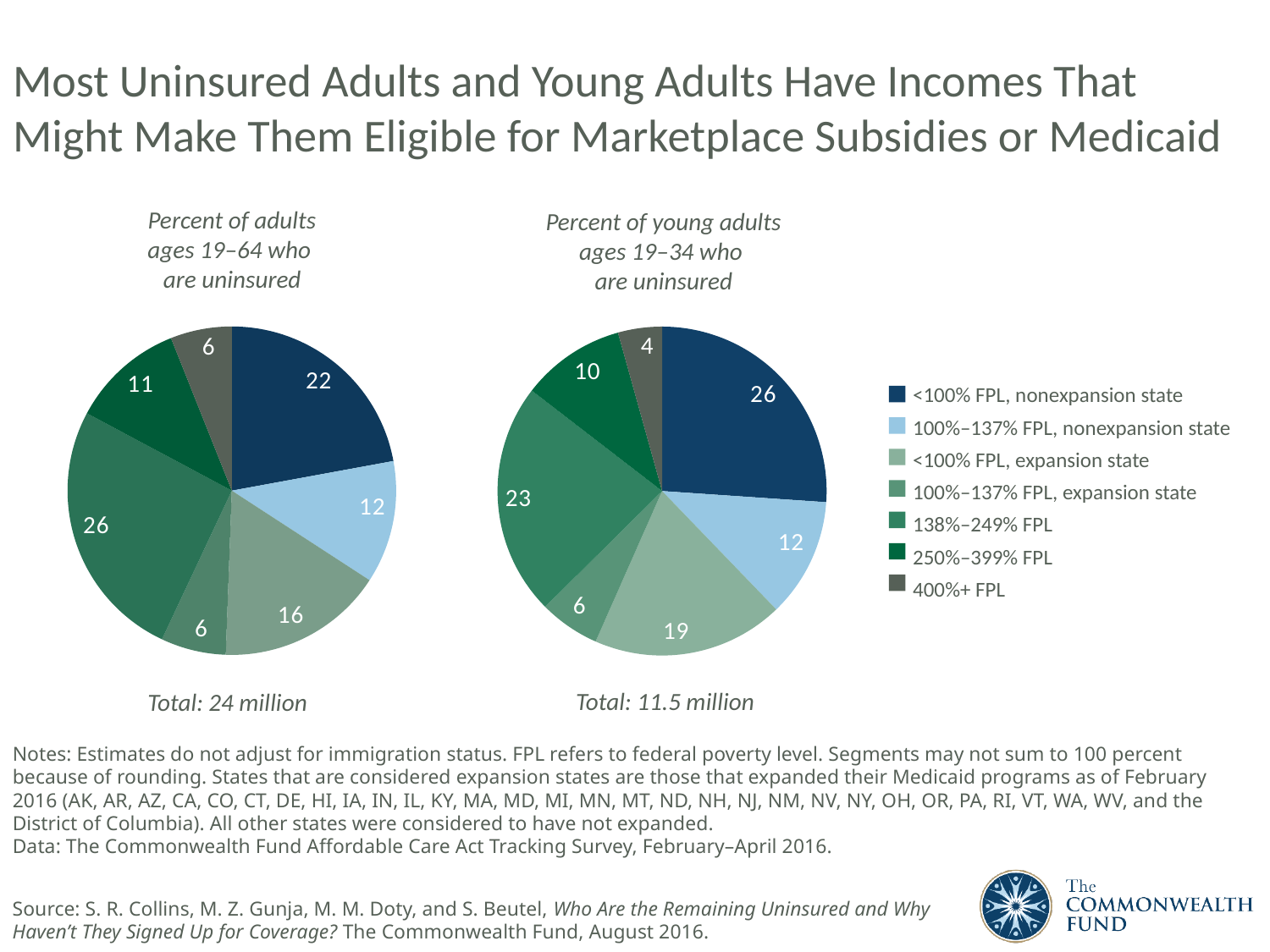
How many slices does the pie chart for young adults ages 19–34 who are uninsured have? 7 What is the difference between the <100% FPL, nonexpansion state share for young adults ages 19–34 and the same share for adults ages 19–64? 4 In the pie chart for young adults ages 19–34 who are uninsured, what percent are in the <100% FPL, expansion state group? 19 What type of chart is used to show the percent of adults ages 19–64 who are uninsured? Pie chart In the pie chart for young adults ages 19–34 who are uninsured, which income group has the largest share? <100% FPL, nonexpansion state In the pie chart for adults ages 19–64 who are uninsured, what percent are in the 400%+ FPL group? 6 In the pie chart for young adults ages 19–34 who are uninsured, which income group has the smallest share? 400%+ FPL In the pie chart for adults ages 19–64 who are uninsured, which income group has the largest share? 138%–249% FPL What total is shown beneath the pie chart for young adults ages 19–34 who are uninsured? Total: 11.5 million In the pie chart for adults ages 19–64 who are uninsured, which is larger: the <100% FPL, expansion state share or the 250%–399% FPL share? <100% FPL, expansion state In the pie chart for adults ages 19–64 who are uninsured, what percent are in the 138%–249% FPL group? 26 How many entries does the legend list? 7